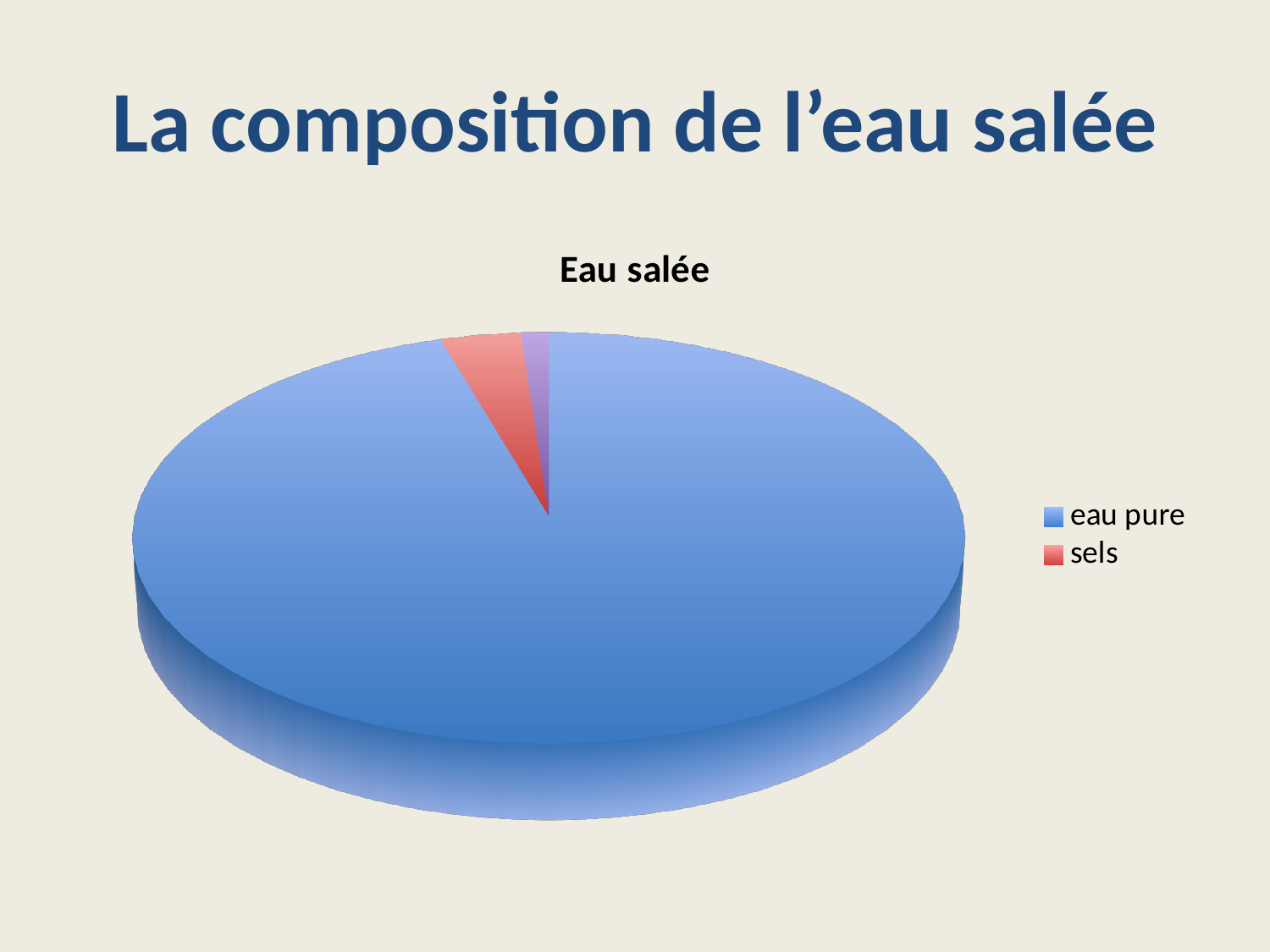
Which category has the largest slice of the pie? eau pure Which of the legend categories has the smallest slice of the pie? sels What colour is used for the eau pure slice? blue What is the title of the chart? Eau salée Which slice is larger, eau pure or sels? eau pure What kind of chart is shown on the slide? pie chart How many entries does the chart's legend list? 2